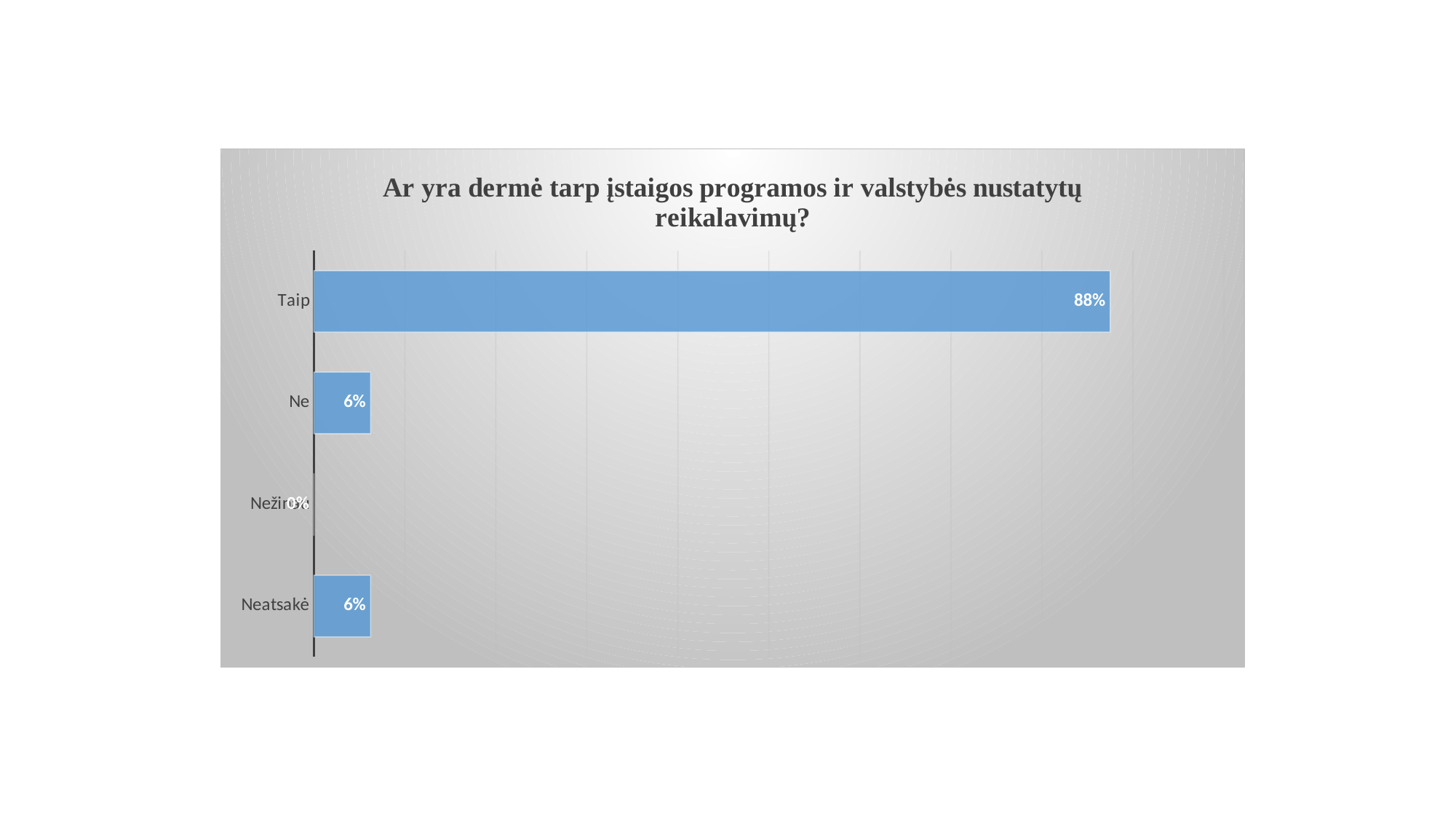
What is the title of the chart? Ar yra dermė tarp įstaigos programos ir valstybės nustatytų reikalavimų? Which category has the highest value? Taip What kind of chart is shown on the slide? Bar chart What is the value for Taip? 88% How many categories are shown in the chart? 4 What is the value for Neatsakė? 6% What is the value for Ne? 6% Which is larger, the value for Taip or the value for Neatsakė? Taip What is the difference between the values for Taip and Ne? 82%